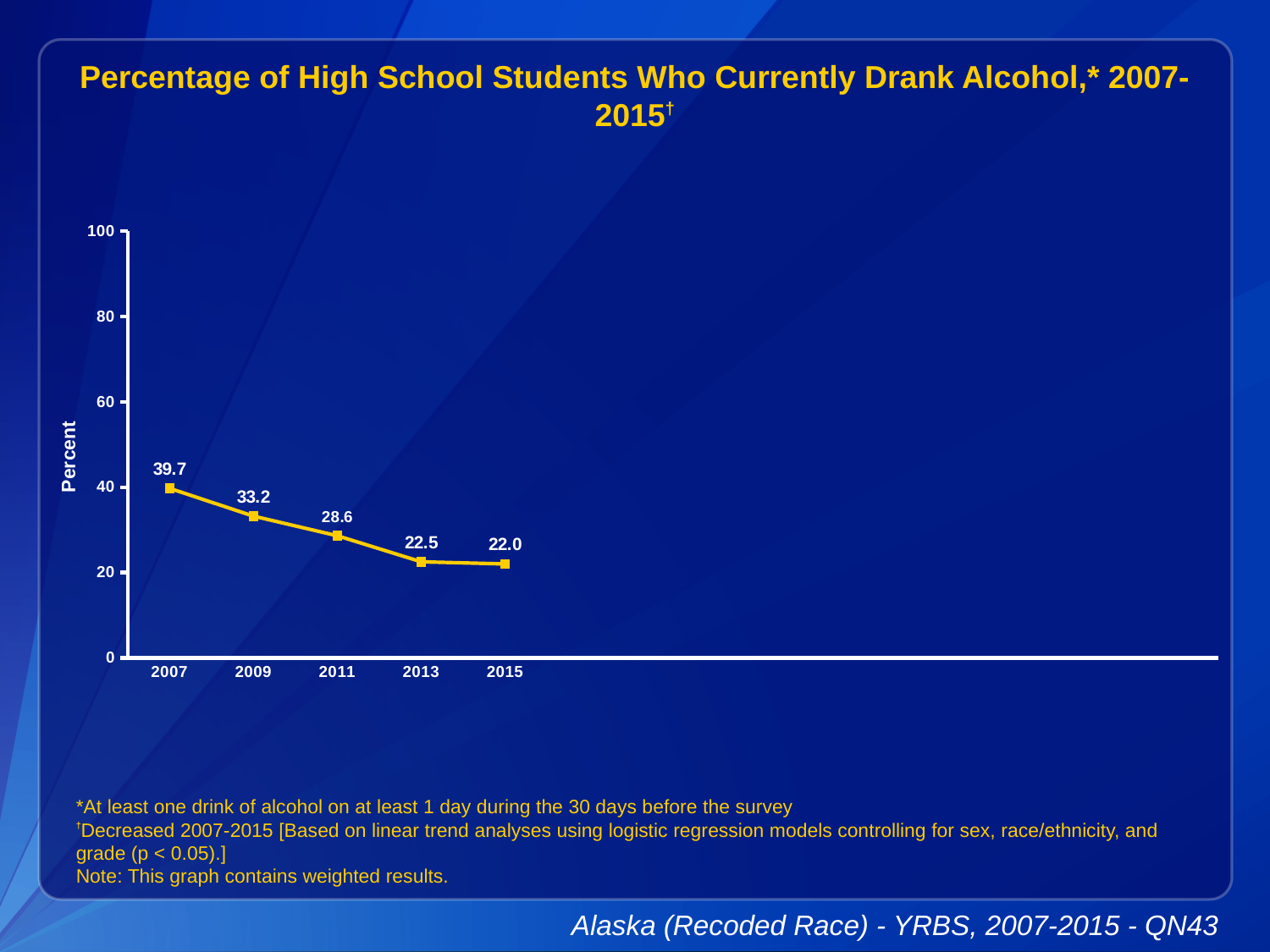
What percentage of high school students currently drank alcohol in 2007? 39.7 Which year has the highest percentage of students who currently drank alcohol? 2007 What is the difference between the 2009 and 2013 values? 10.7 Which year has a larger value, 2009 or 2011? 2009 Do the values rise or fall from 2007 to 2015? Fall What kind of chart is shown on the slide? Line chart How many years are plotted on the chart? 5 What is the value plotted for 2015? 22.0 Is the value for 2007 greater or less than 40? less By how many percentage points did the value fall from 2007 to 2015? 17.7 What is the value plotted for 2011? 28.6 Which year has the lowest percentage of students who currently drank alcohol? 2015